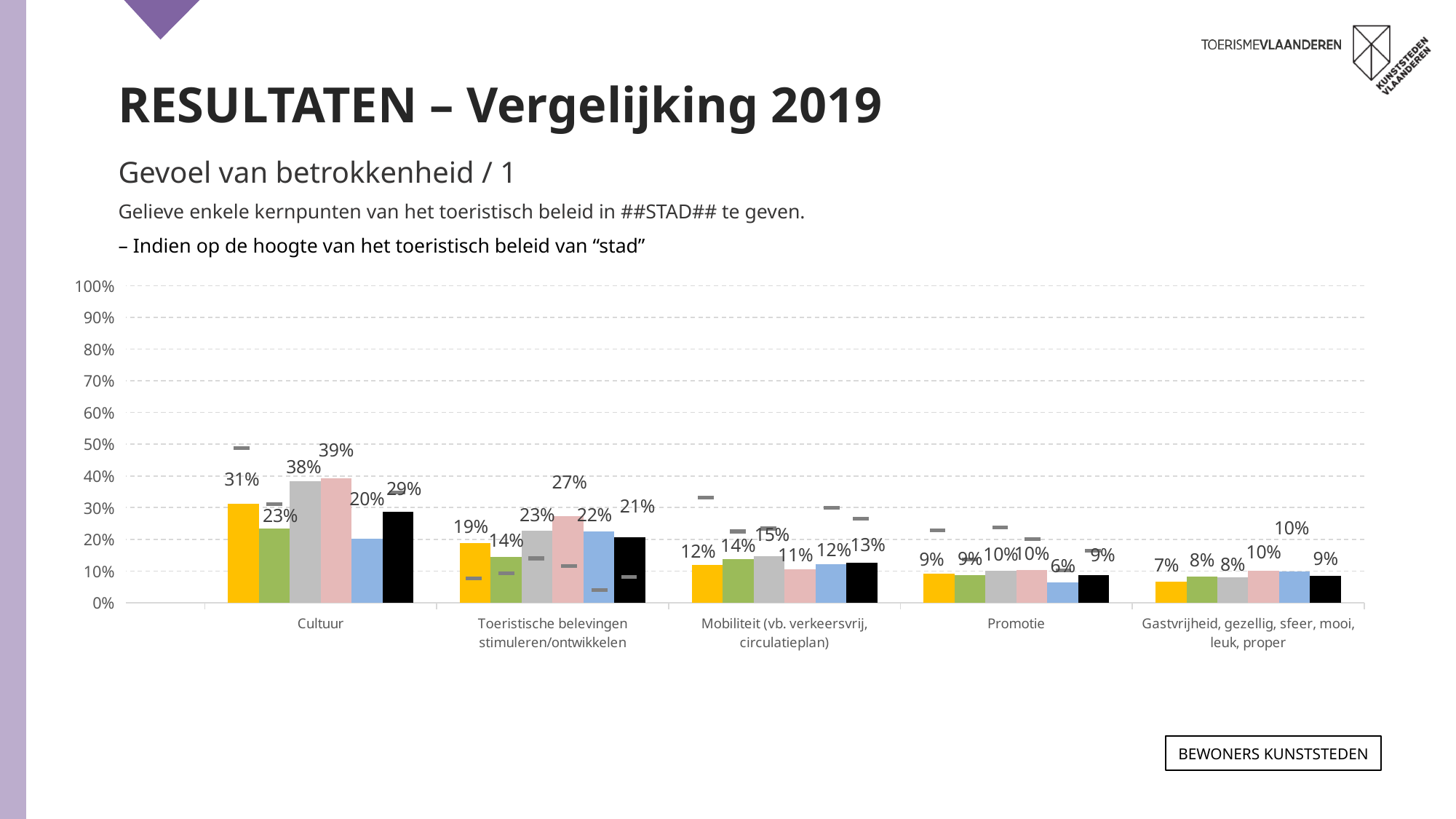
What is the value of the blue bar for Promotie? 6% What is the value of the pink bar for Toeristische belevingen stimuleren/ontwikkelen? 27% What is the value of the yellow bar for Cultuur? 31% What is the difference between the pink bar and the yellow bar for Cultuur? 8% What is the value of the black bar for Gastvrijheid, gezellig, sfeer, mooi, leuk, proper? 9% Which is larger for Mobiliteit (vb. verkeersvrij, circulatieplan): the grey bar or the pink bar? grey bar What kind of chart is shown on the slide? bar chart Which category has the highest bar in the chart? Cultuur Within the Cultuur category, which coloured bar is the lowest? blue How many categories are shown on the x axis? 5 What is the highest value shown on the y axis? 100% Is the value of the grey bar for Cultuur greater or less than 30%? greater